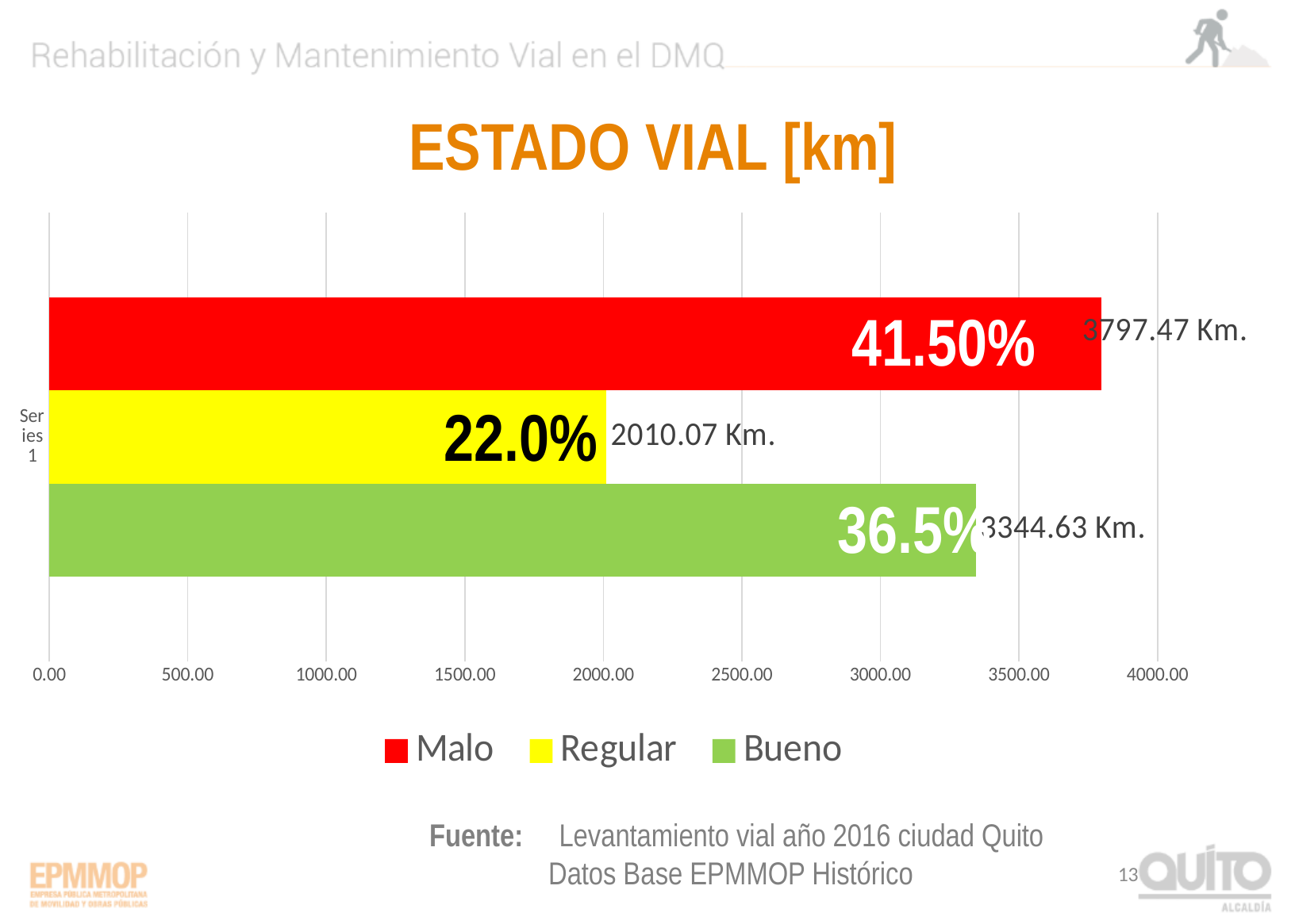
Which category has the lowest value? Regular What percentage is shown on the Regular bar? 22.0% What percentage is shown on the Malo bar? 41.50% What is the value in km for Malo? 3797.47 Km. What is the difference in km between Malo and Regular? 1787.40 Km. Which category has the highest value? Malo What is the value in km for Regular? 2010.07 Km. What is the value in km for Bueno? 3344.63 Km. What type of chart is shown on the slide? bar chart How many categories does the legend list? 3 What is the title of the chart? ESTADO VIAL [km] Which is larger, the value for Bueno or the value for Regular? Bueno